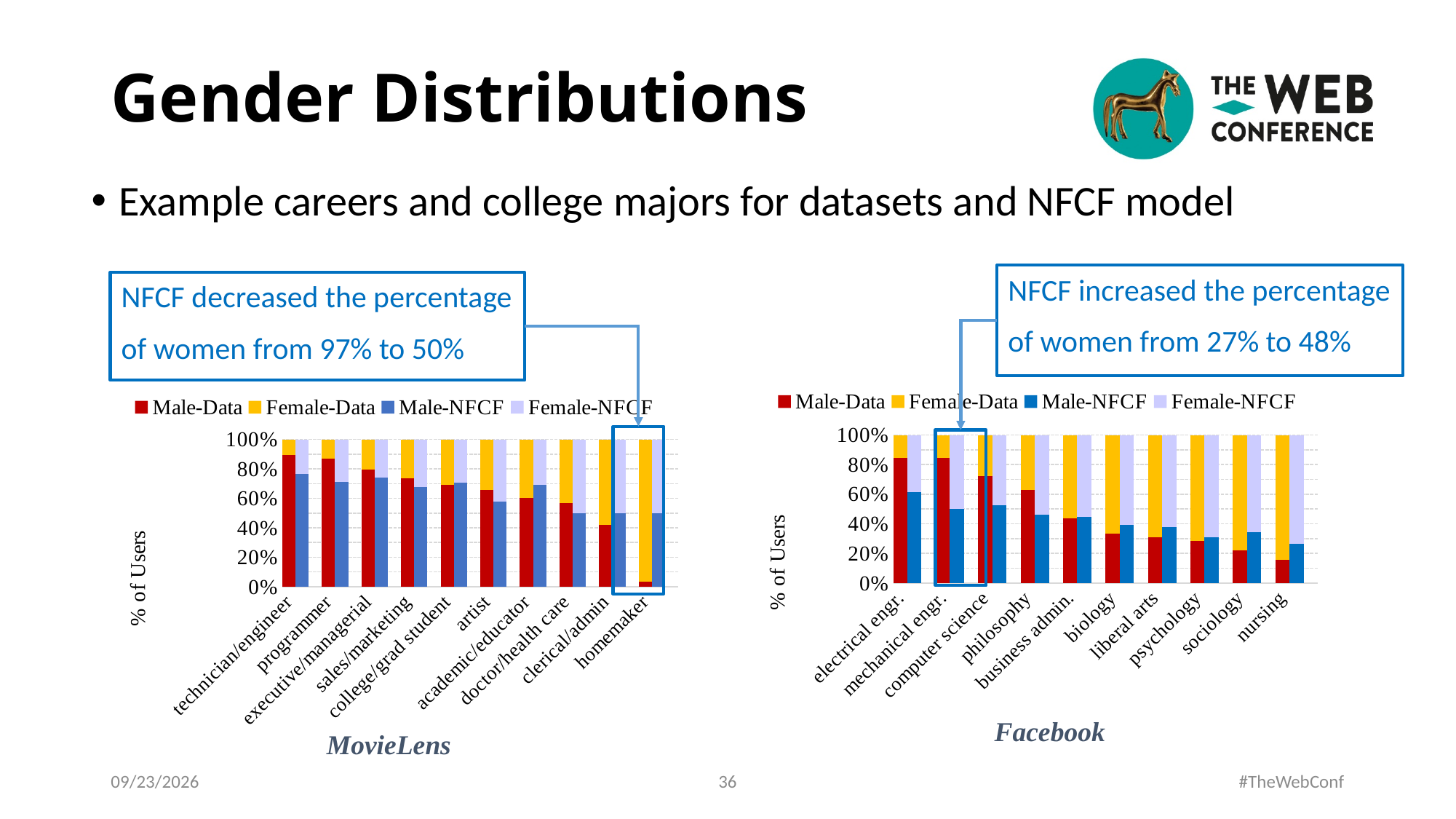
How many series does the legend of the Facebook chart list? 4 How many college majors are shown on the x axis of the Facebook chart? 10 In the MovieLens chart, is the Male-Data value for technician/engineer greater or less than 80%? greater In the Facebook chart, does the Male-Data value rise or fall moving from electrical engr. to nursing along the x axis? fall In the Facebook chart, which major has the lowest Male-Data value? nursing In the Facebook chart, according to the callout, what was the percentage of women for mechanical engr. in the data before NFCF? 27% In the MovieLens chart, according to the callout, what was the percentage of women for homemaker in the data before NFCF? 97% In the Facebook chart, according to the callout, what did NFCF increase the percentage of women for mechanical engr. to? 48% In the MovieLens chart, according to the callout, what did NFCF change the percentage of women for homemaker to? 50% In the MovieLens chart, which category has the lowest Male-Data value? homemaker How many career categories are shown on the x axis of the MovieLens chart? 10 What kind of chart is the MovieLens chart? stacked bar chart